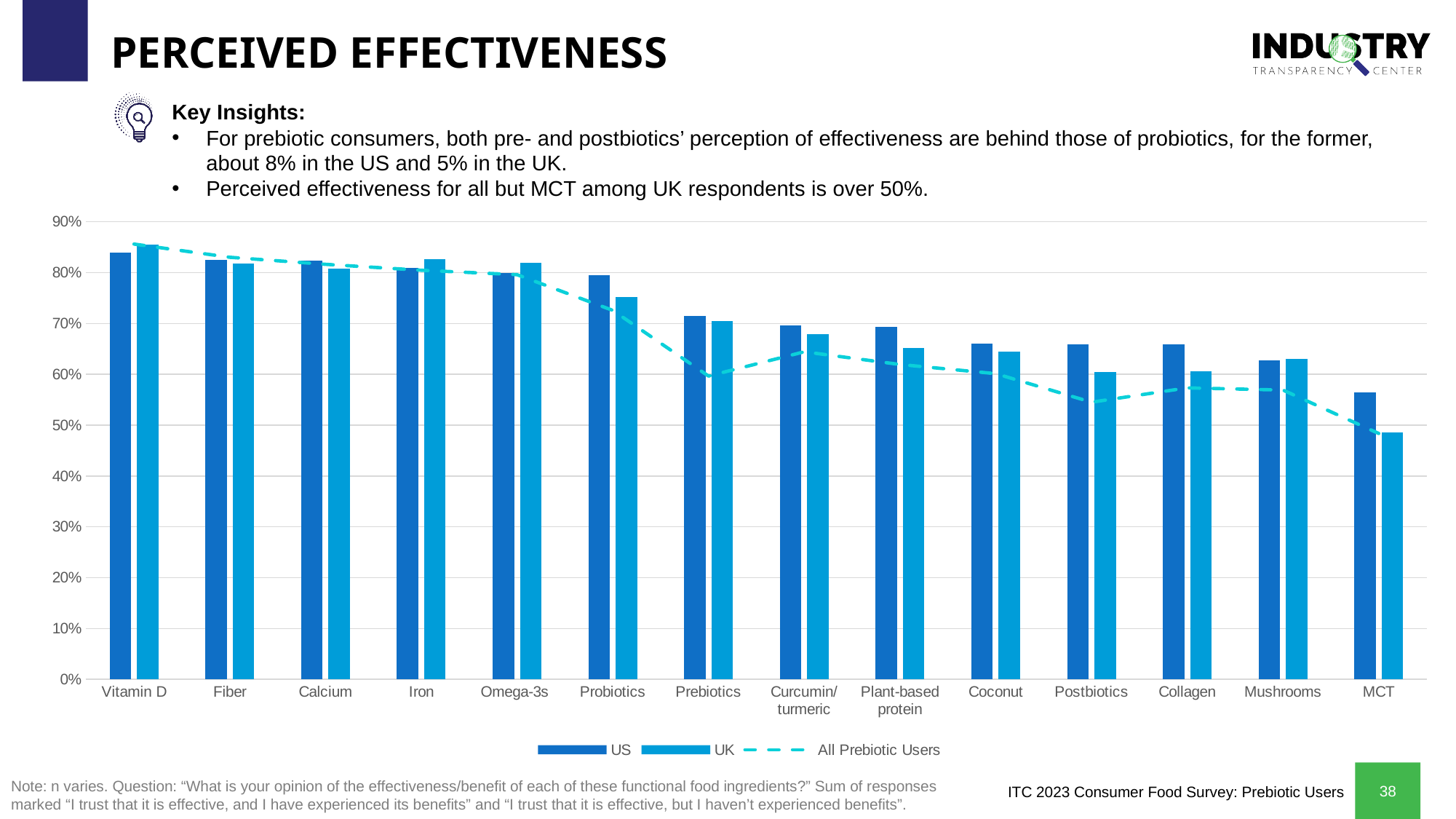
What kind of chart is shown on the slide? Combination bar and line chart Which ingredient has the lowest UK value? MCT Do the US values generally rise or fall moving from left to right along the x axis? Fall For Omega-3s, which is larger, the US value or the UK value? UK For Postbiotics, which is larger, the US value or the UK value? US Which ingredient has the lowest US value? MCT Is the US value for Probiotics greater or less than 70%? greater How many series does the legend list? 3 Is the UK value for MCT greater or less than 50%? less How many ingredient categories are shown on the x axis? 14 Which ingredient has the highest US value? Vitamin D Is the US value for Vitamin D greater or less than 80%? greater